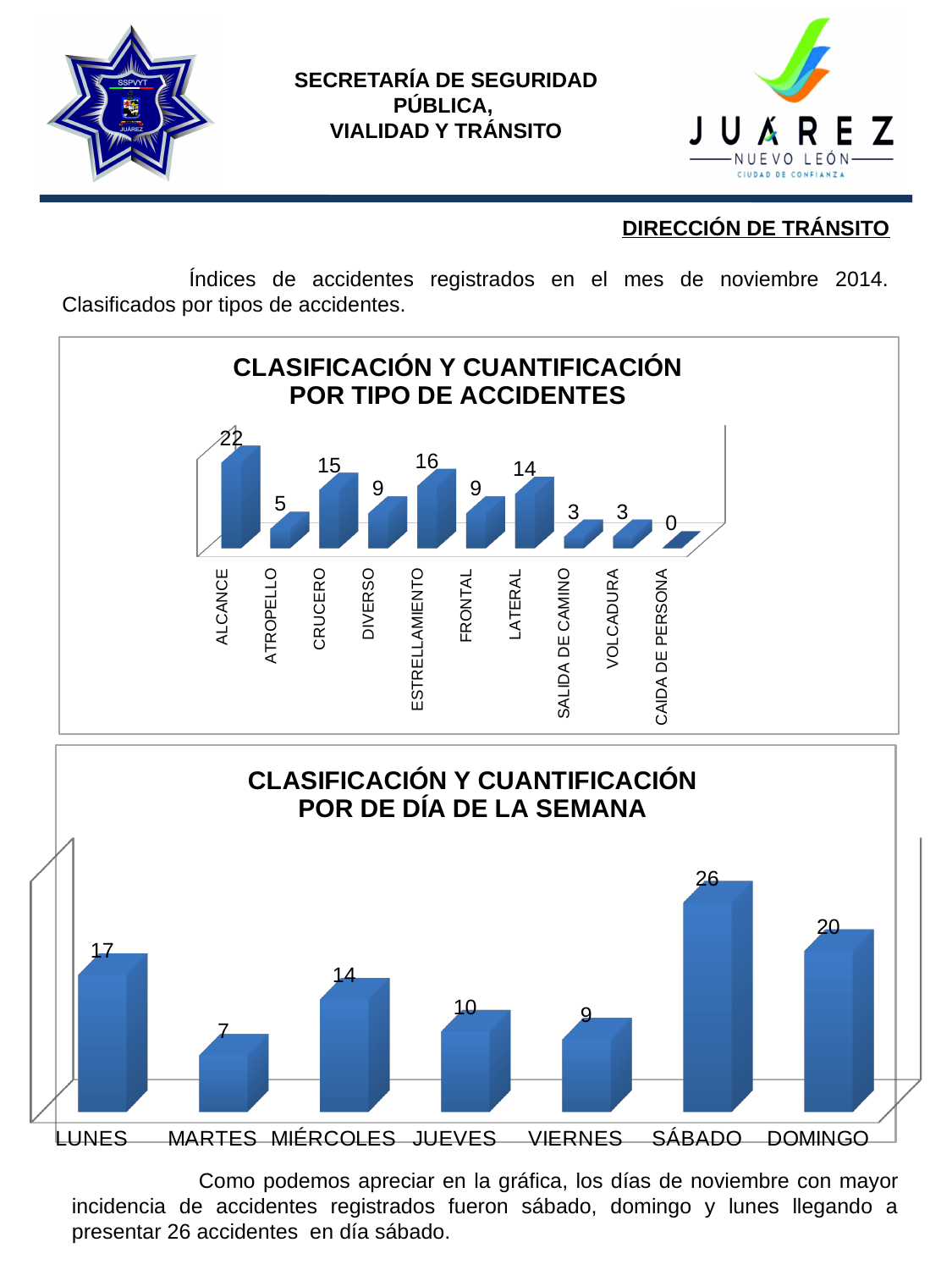
In the 'CLASIFICACIÓN Y CUANTIFICACIÓN POR DE DÍA DE LA SEMANA' chart, what is the value for SÁBADO? 26 What kind of chart is the 'CLASIFICACIÓN Y CUANTIFICACIÓN POR DE DÍA DE LA SEMANA' chart? Bar chart In the 'CLASIFICACIÓN Y CUANTIFICACIÓN POR TIPO DE ACCIDENTES' chart, which is larger, LATERAL or FRONTAL? LATERAL In the 'CLASIFICACIÓN Y CUANTIFICACIÓN POR TIPO DE ACCIDENTES' chart, which category has the highest value? ALCANCE In the 'CLASIFICACIÓN Y CUANTIFICACIÓN POR DE DÍA DE LA SEMANA' chart, what is the difference between SÁBADO and DOMINGO? 6 In the 'CLASIFICACIÓN Y CUANTIFICACIÓN POR TIPO DE ACCIDENTES' chart, what is the value for ALCANCE? 22 In the 'CLASIFICACIÓN Y CUANTIFICACIÓN POR TIPO DE ACCIDENTES' chart, how many categories are shown? 10 In the 'CLASIFICACIÓN Y CUANTIFICACIÓN POR TIPO DE ACCIDENTES' chart, what is the difference between ESTRELLAMIENTO and CRUCERO? 1 In the 'CLASIFICACIÓN Y CUANTIFICACIÓN POR TIPO DE ACCIDENTES' chart, which category has the lowest value? CAIDA DE PERSONA In the 'CLASIFICACIÓN Y CUANTIFICACIÓN POR DE DÍA DE LA SEMANA' chart, which day has the lowest value? MARTES In the 'CLASIFICACIÓN Y CUANTIFICACIÓN POR DE DÍA DE LA SEMANA' chart, which is larger, LUNES or MIÉRCOLES? LUNES In the 'CLASIFICACIÓN Y CUANTIFICACIÓN POR DE DÍA DE LA SEMANA' chart, how many days are shown? 7